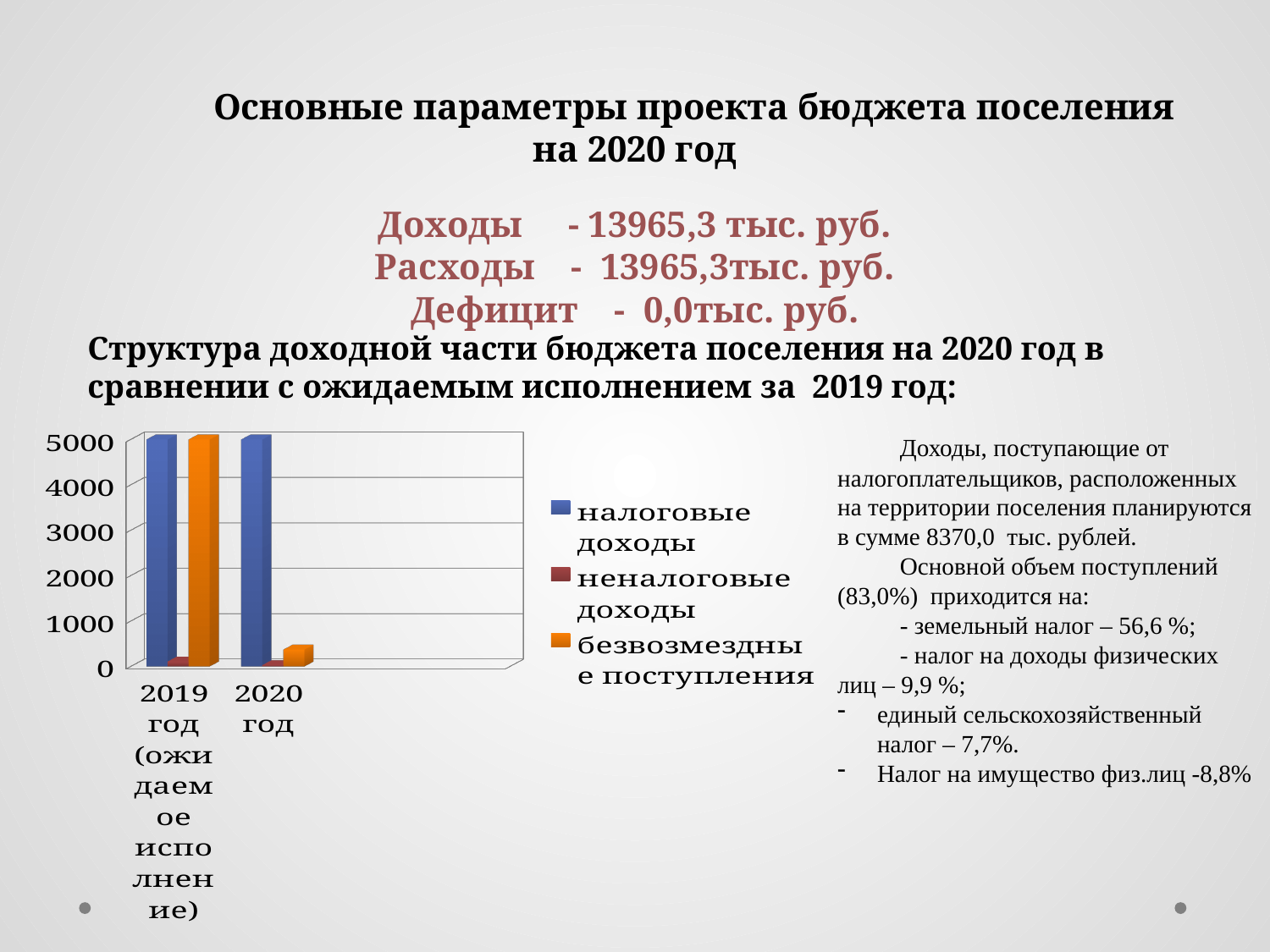
Which series has the highest value for 2020 год? налоговые доходы What is the highest tick value shown on the vertical axis of the chart? 5000 How many categories are shown on the x axis of the chart? 2 What kind of chart is shown on the slide? bar chart Do the values for безвозмездные поступления rise or fall from 2019 год to 2020 год? fall How many series does the chart legend list? 3 Which series is shown in orange in the chart legend? безвозмездные поступления Which series has the lowest value for 2020 год? неналоговые доходы Is the value for неналоговые доходы in 2019 год (ожидаемое исполнение) greater or less than 1000? less Is the value for безвозмездные поступления in 2020 год greater or less than 1000? less Which is larger: безвозмездные поступления in 2019 год (ожидаемое исполнение) or in 2020 год? 2019 год (ожидаемое исполнение) Is the value for налоговые доходы in 2020 год greater or less than 4000? greater